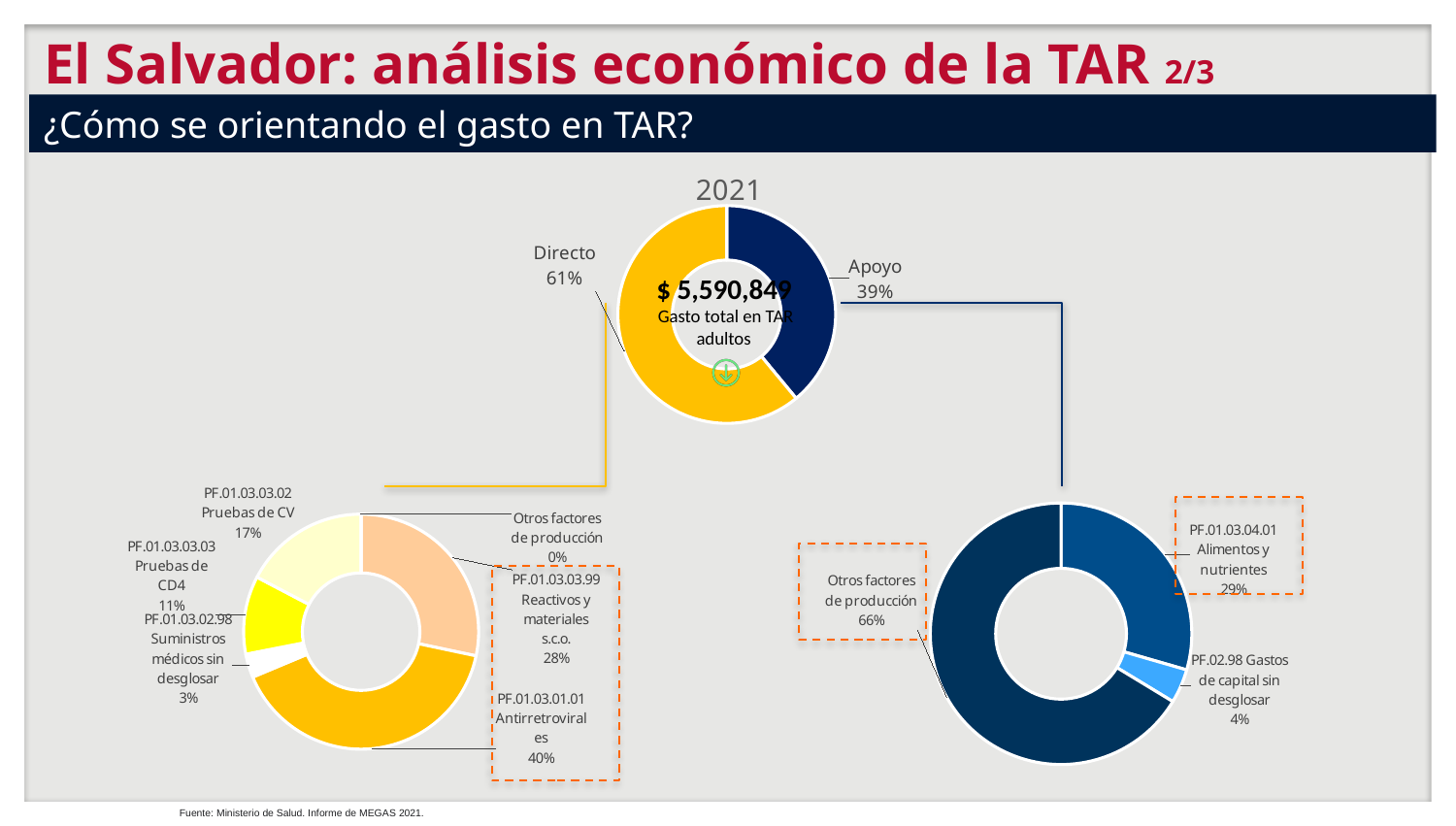
In the top donut chart titled 2021, what share is labelled Directo? 61% In the bottom-left donut chart, which category has the largest share? PF.01.03.01.01 Antirretrovirales In the bottom-left donut chart, what share is labelled PF.01.03.03.99 Reactivos y materiales s.c.o.? 28% In the bottom-left donut chart, what share is labelled PF.01.03.02.98 Suministros médicos sin desglosar? 3% In the top donut chart titled 2021, which segment is larger, Directo or Apoyo? Directo In the bottom-right donut chart, what share is labelled Otros factores de producción? 66% In the top donut chart titled 2021, what total amount is shown in the centre of the chart? $ 5,590,849 In the bottom-right donut chart, which category has the smallest share? PF.02.98 Gastos de capital sin desglosar In the bottom-left donut chart, how many categories are labelled? 6 In the top donut chart titled 2021, what share is labelled Apoyo? 39% In the top donut chart titled 2021, what is the difference in percentage points between Directo and Apoyo? 22 In the bottom-left donut chart, what share is labelled PF.01.03.01.01 Antirretrovirales? 40%